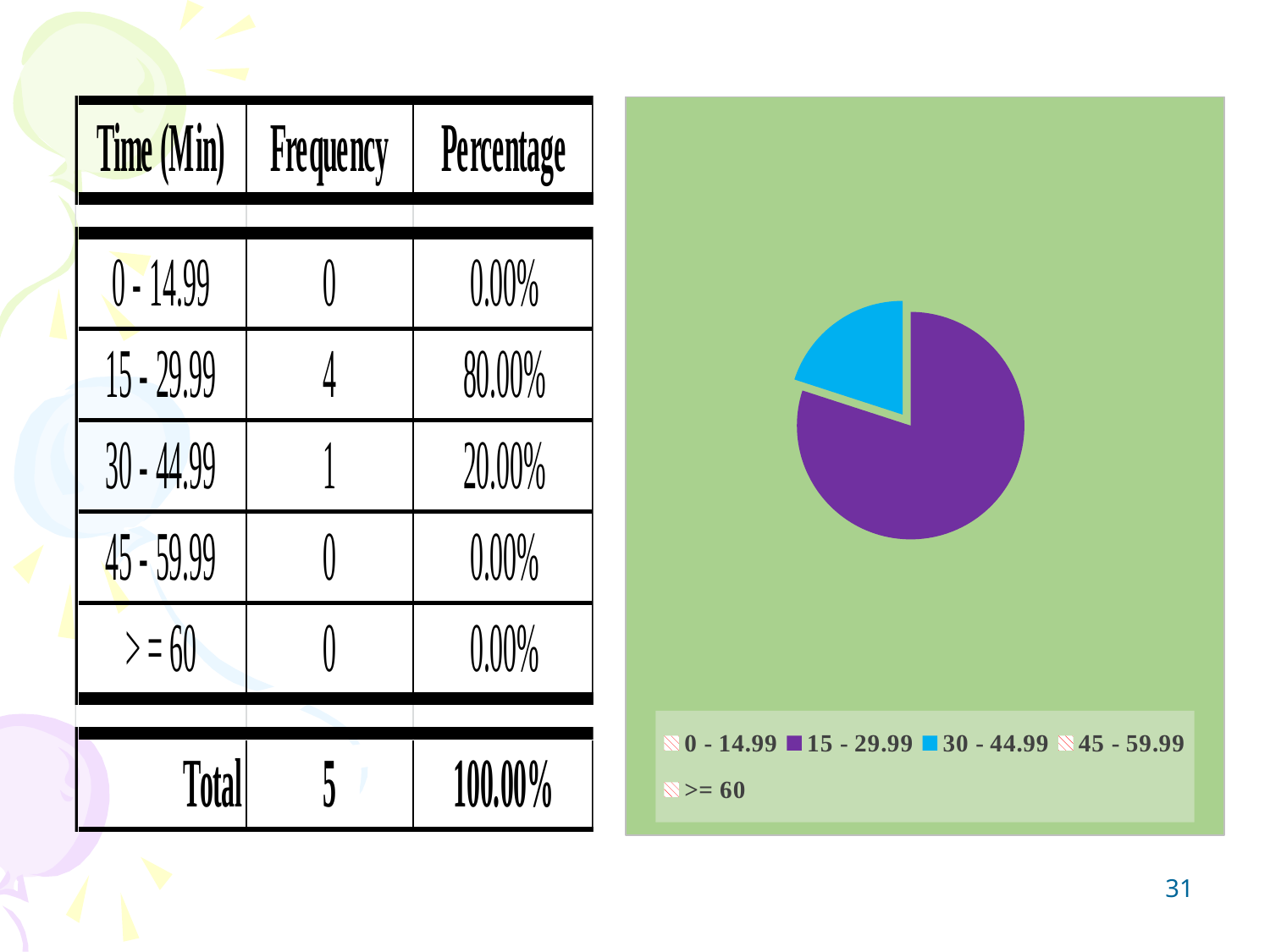
What is the frequency for the 15 - 29.99 time category in the table? 4 What colour is the 30 - 44.99 slice in the pie chart? blue What colour is the 15 - 29.99 slice in the pie chart? purple Which of the two visible slices in the pie chart is larger, 15 - 29.99 or 30 - 44.99? 15 - 29.99 How many entries does the pie chart's legend list? 5 What is the frequency for the 30 - 44.99 time category in the table? 1 According to the table, what share of the pie does the 15 - 29.99 slice represent? 80.00% According to the table, what share of the pie does the 30 - 44.99 slice represent? 20.00% What is the total frequency shown in the table? 5 How many slices are visibly drawn in the pie chart? 2 Which time category has the largest slice in the pie chart? 15 - 29.99 What kind of chart is shown on the right of the slide? pie chart